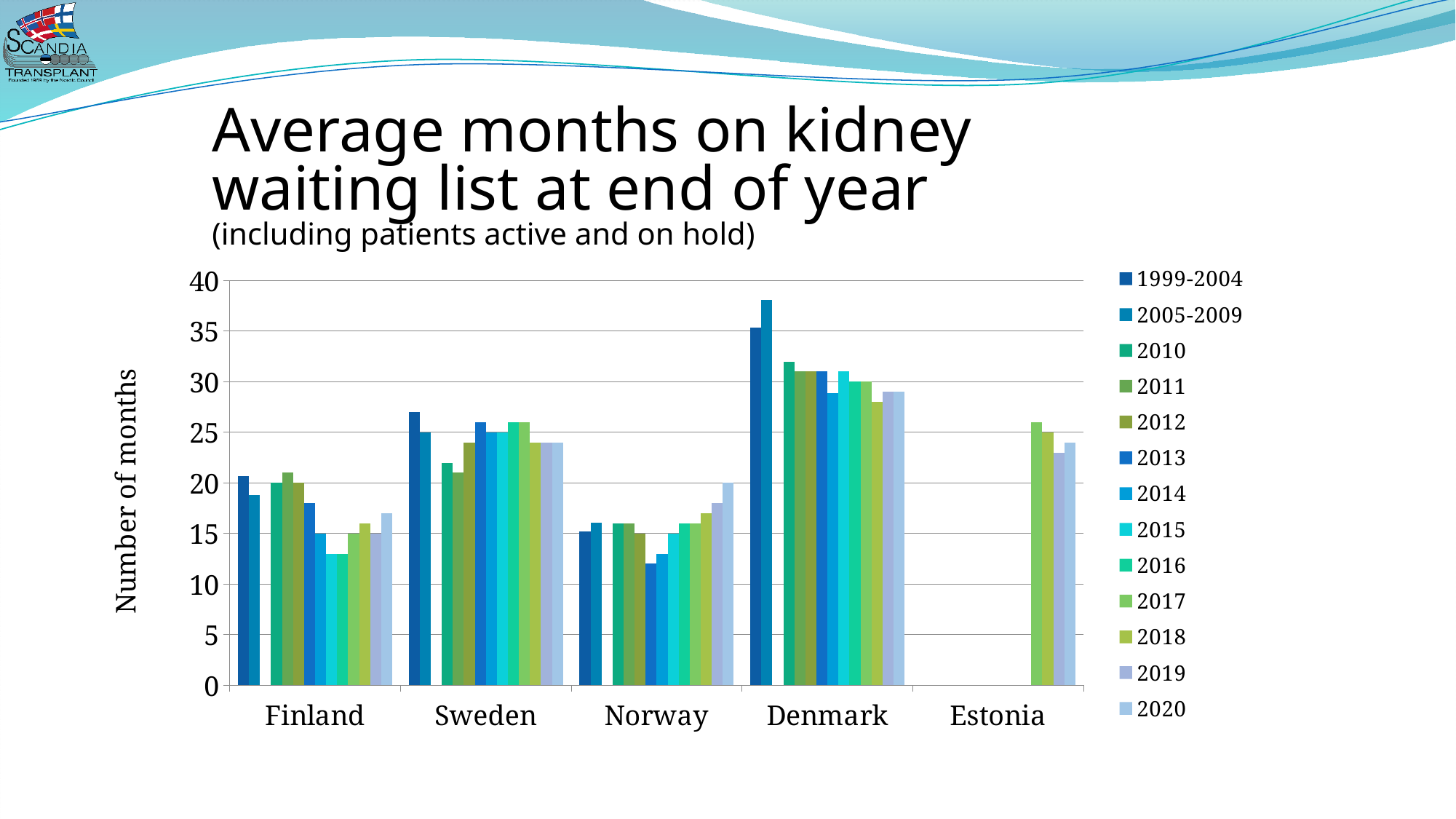
Is the value for Norway in 2013 greater or less than 15? less What is the label on the y axis? Number of months Which is larger, the 1999-2004 value for Sweden or for Finland? Sweden How many series does the legend list? 13 What kind of chart is shown on the slide? bar chart Is the value for Finland in 1999-2004 greater or less than 20? greater Which country has the lowest value for 2013? Norway Is the value for Estonia in 2019 greater or less than 25? less How many countries are shown on the x axis? 5 Which country has the highest value for 2005-2009? Denmark